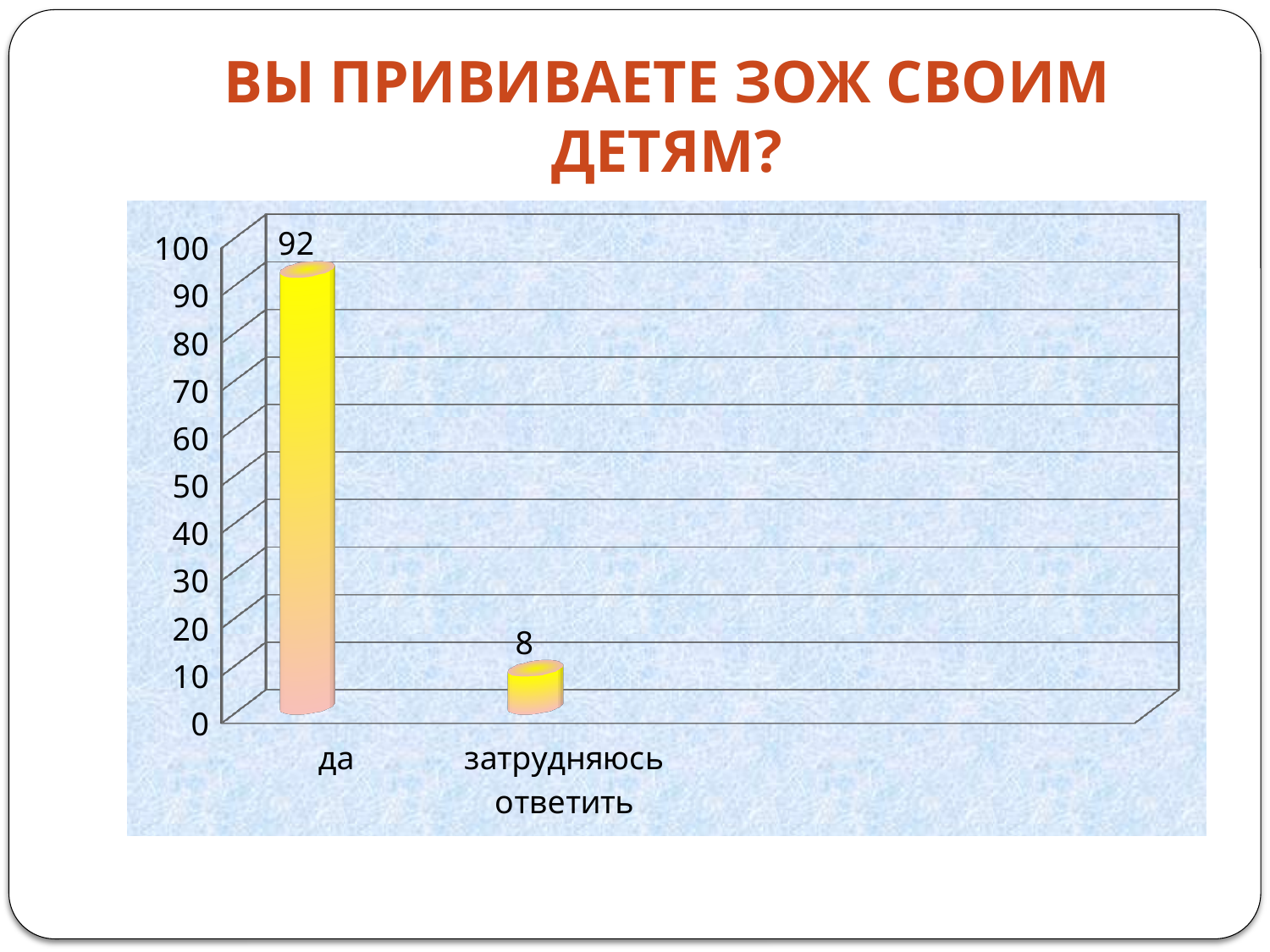
Which is larger, the value for "да" or the value for "затрудняюсь ответить"? да What kind of chart is shown on the slide? bar chart What is the total of the two values shown on the chart? 100 Which category has the highest value? да How many categories are shown on the chart? 2 Is the value for "затрудняюсь ответить" greater or less than 10? less What is the title of the slide? ВЫ ПРИВИВАЕТЕ ЗОЖ СВОИМ ДЕТЯМ? What is the value for "да"? 92 Is the value for "да" greater or less than 50? greater What is the value for "затрудняюсь ответить"? 8 What is the difference between the values for "да" and "затрудняюсь ответить"? 84 Which category has the lowest value? затрудняюсь ответить